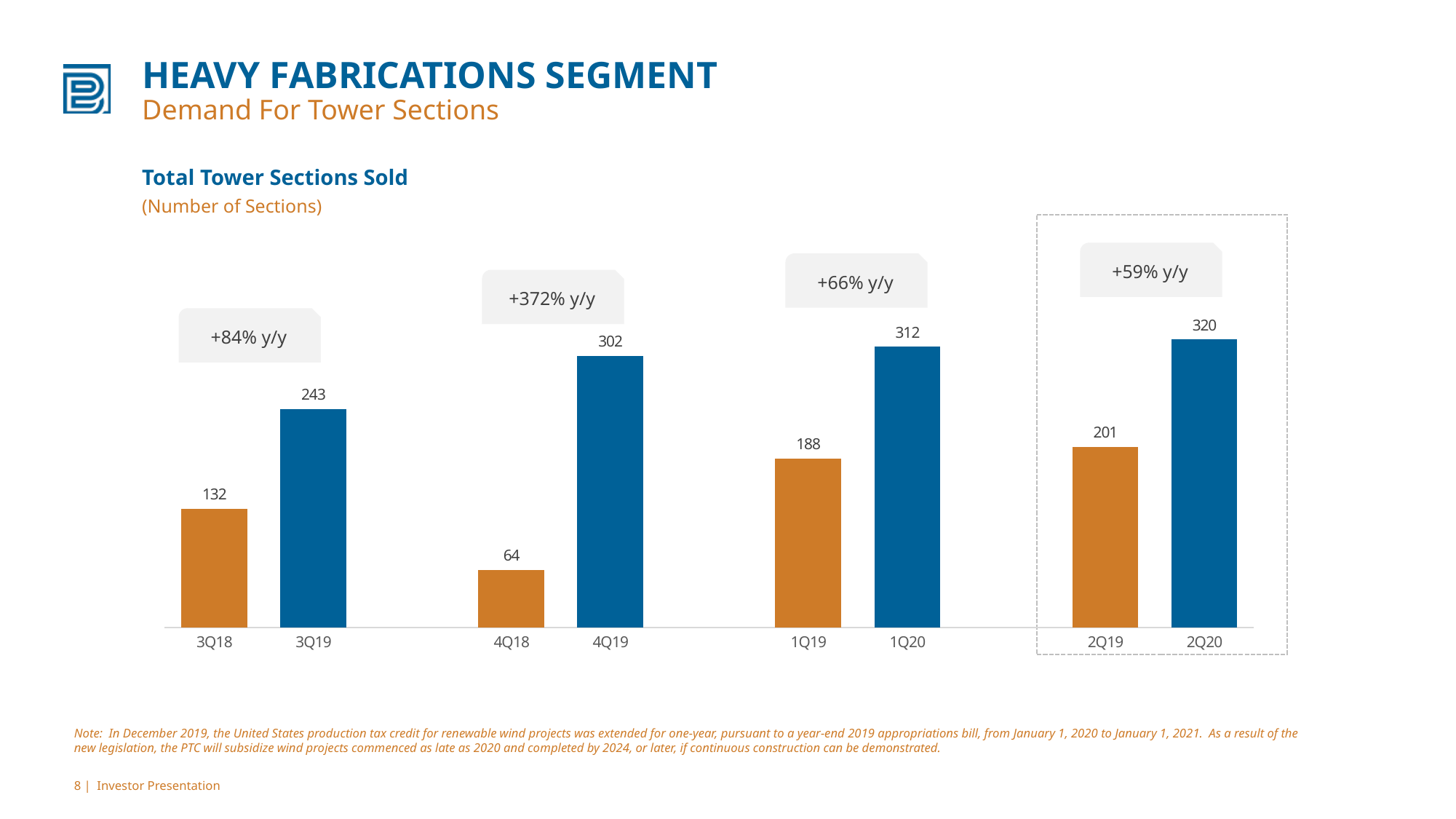
How many bars are plotted in the chart? 8 Which quarter has the highest number of tower sections sold? 2Q20 Which is larger, the value for 3Q19 or the value for 1Q20? 1Q20 How many tower sections were sold in 3Q19? 243 What kind of chart is shown on the slide? Bar chart What is the difference between the values for 2Q20 and 2Q19? 119 What is the value shown for 1Q19? 188 What is the value shown for 4Q18? 64 How many tower sections were sold in 2Q20? 320 What year-over-year percentage change is shown above the 4Q19 bar? +372% y/y What is the difference between the values for 4Q19 and 4Q18? 238 Which quarter has the lowest number of tower sections sold? 4Q18